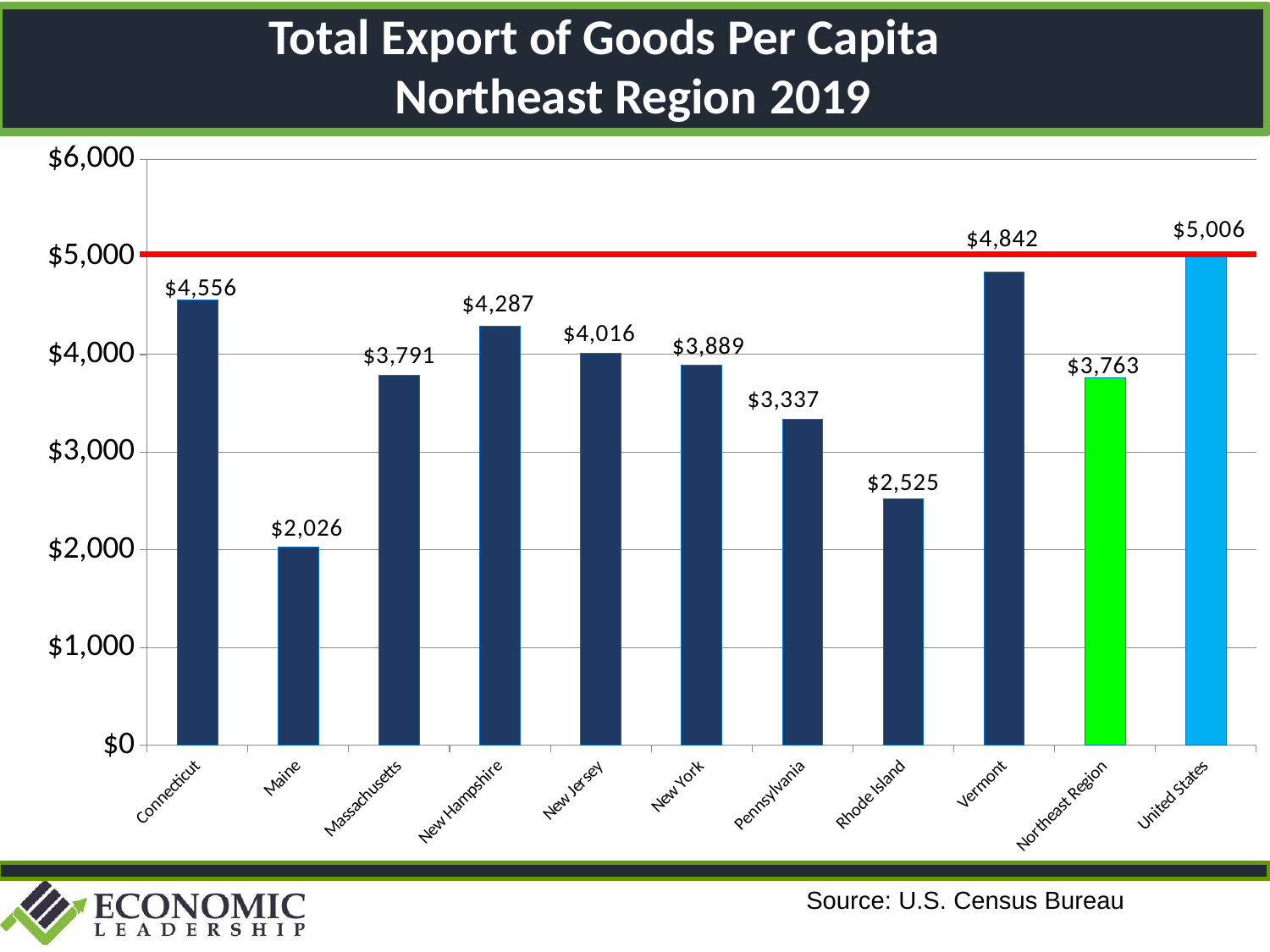
What kind of chart is shown on the slide? Bar chart What is the title of the chart? Total Export of Goods Per Capita Northeast Region 2019 What colour is the bar for the Northeast Region? Green What is the value shown for Rhode Island? $2,525 Which category has the highest export of goods per capita? United States Which is larger, the value for New Jersey or the value for New York? New Jersey Is the value for Pennsylvania greater or less than $3,000? greater What is the total export of goods per capita for Connecticut? $4,556 How many bars are shown in the chart? 11 What is the value shown for the Northeast Region? $3,763 Which state has the lowest export of goods per capita? Maine What is the difference between the values for Vermont and Maine? $2,816